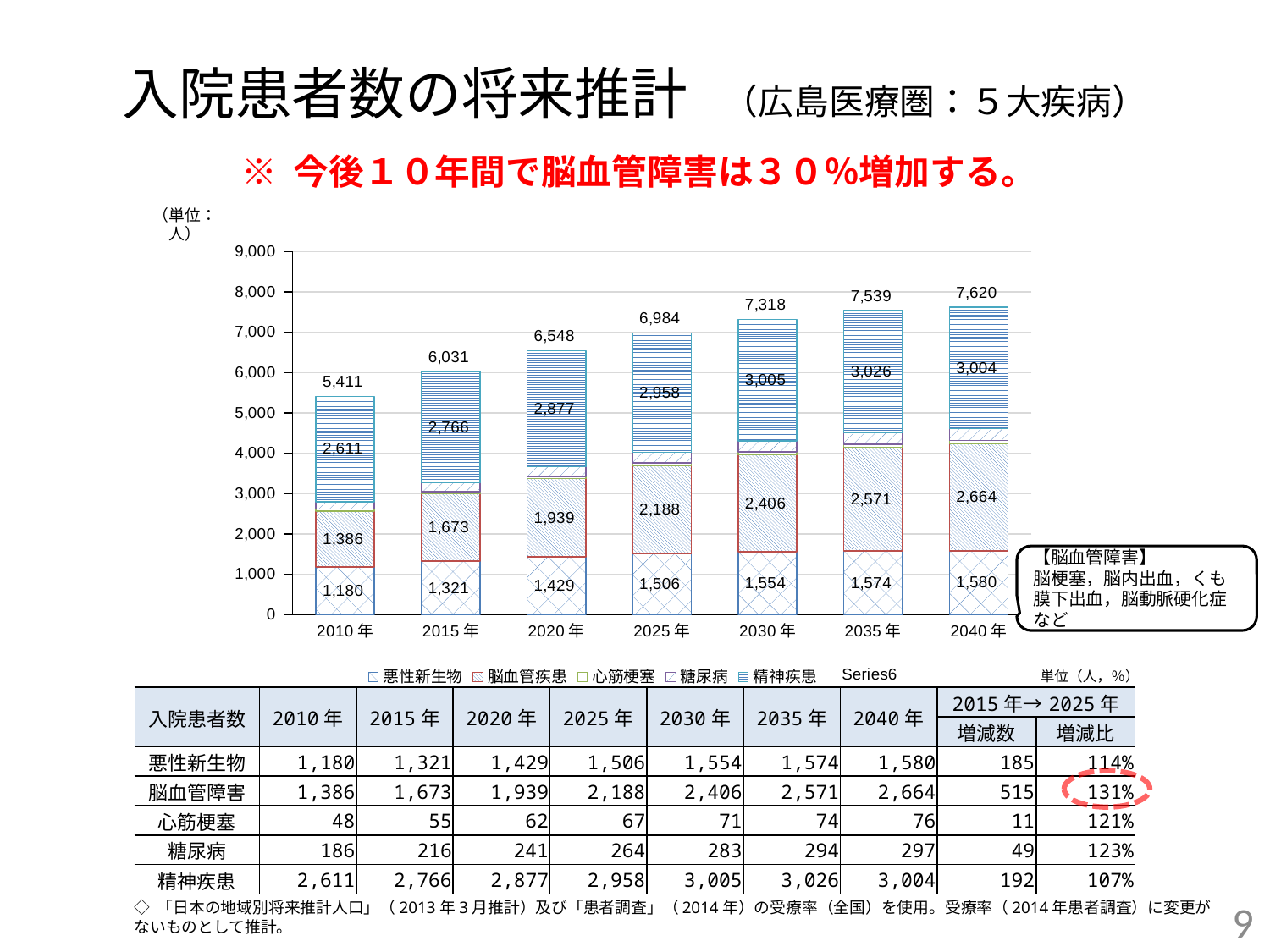
How many years (bars) are plotted along the x axis of the chart? 7 What is the value of the 悪性新生物 segment in the 2020年 bar? 1,429 Do the total inpatient numbers rise or fall from 2010年 to 2040年? rise What is the total labelled on the bar for 2040年? 7,620 Which year has the highest total number of inpatients? 2040年 What is the difference between the 脳血管疾患 values for 2040年 and 2010年? 1,278 Which year has the lowest total number of inpatients? 2010年 What is the value of the 脳血管疾患 segment in the 2025年 bar? 2,188 What type of chart is shown on the slide? stacked bar chart What is the value of the 精神疾患 segment in the 2035年 bar? 3,026 In the 2030年 bar, which is larger: the 精神疾患 segment or the 脳血管疾患 segment? 精神疾患 What is the total number of inpatients shown above the bar for 2010年? 5,411